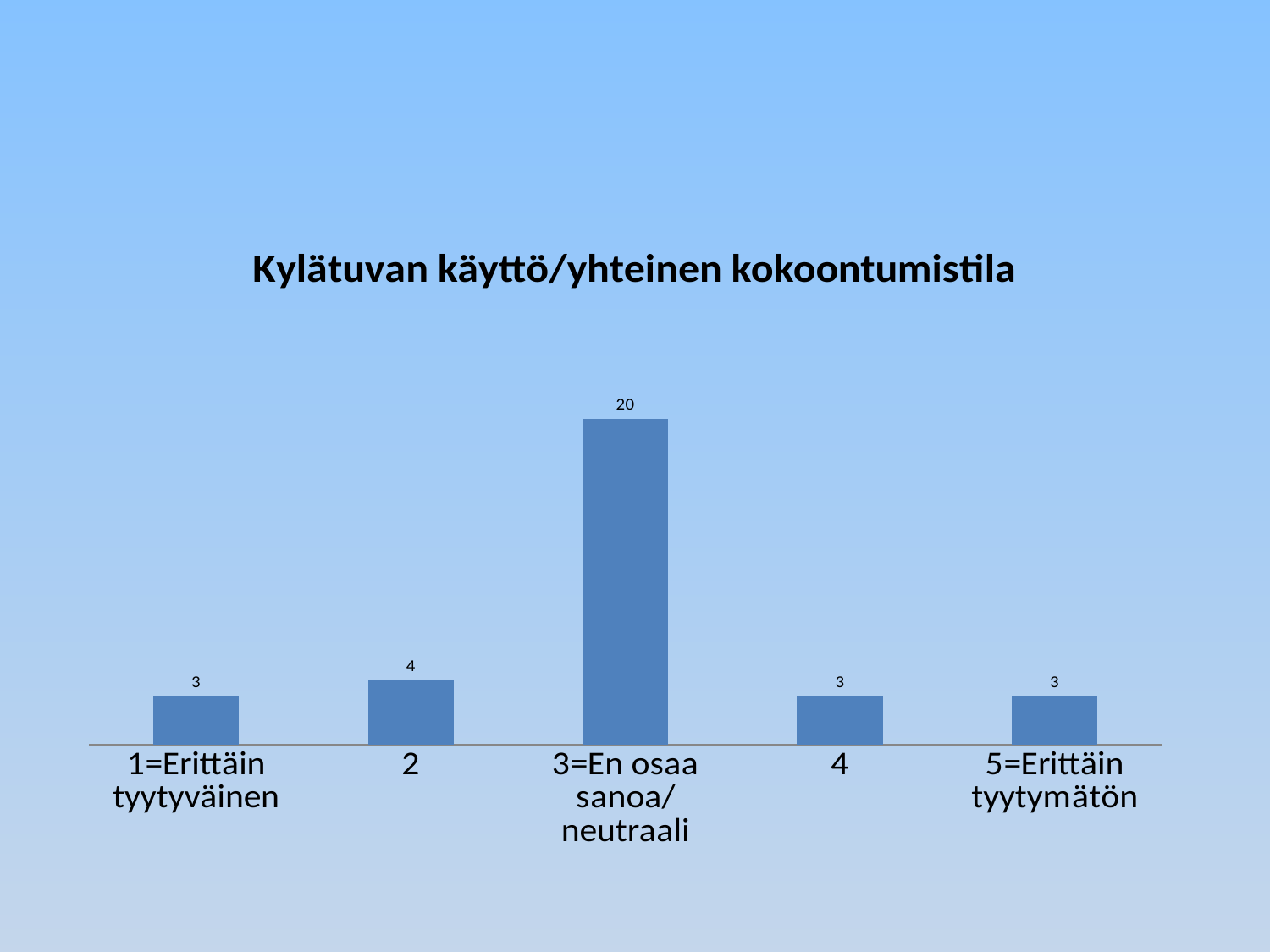
Which category has the highest value? 3=En osaa sanoa/neutraali What kind of chart is shown on the slide? Bar chart How many categories are shown on the x axis? 5 What is the total of all the values shown in the chart? 33 What is the title of the chart? Kylätuvan käyttö/yhteinen kokoontumistila What is the value for the category "3=En osaa sanoa/neutraali"? 20 What is the difference between the values for "2" and "4"? 1 What is the value for the category "5=Erittäin tyytymätön"? 3 What is the value for the category "2"? 4 What is the difference between the values for "3=En osaa sanoa/neutraali" and "2"? 16 Which is larger, the value for "2" or the value for "4"? 2 What is the value for the category "1=Erittäin tyytyväinen"? 3